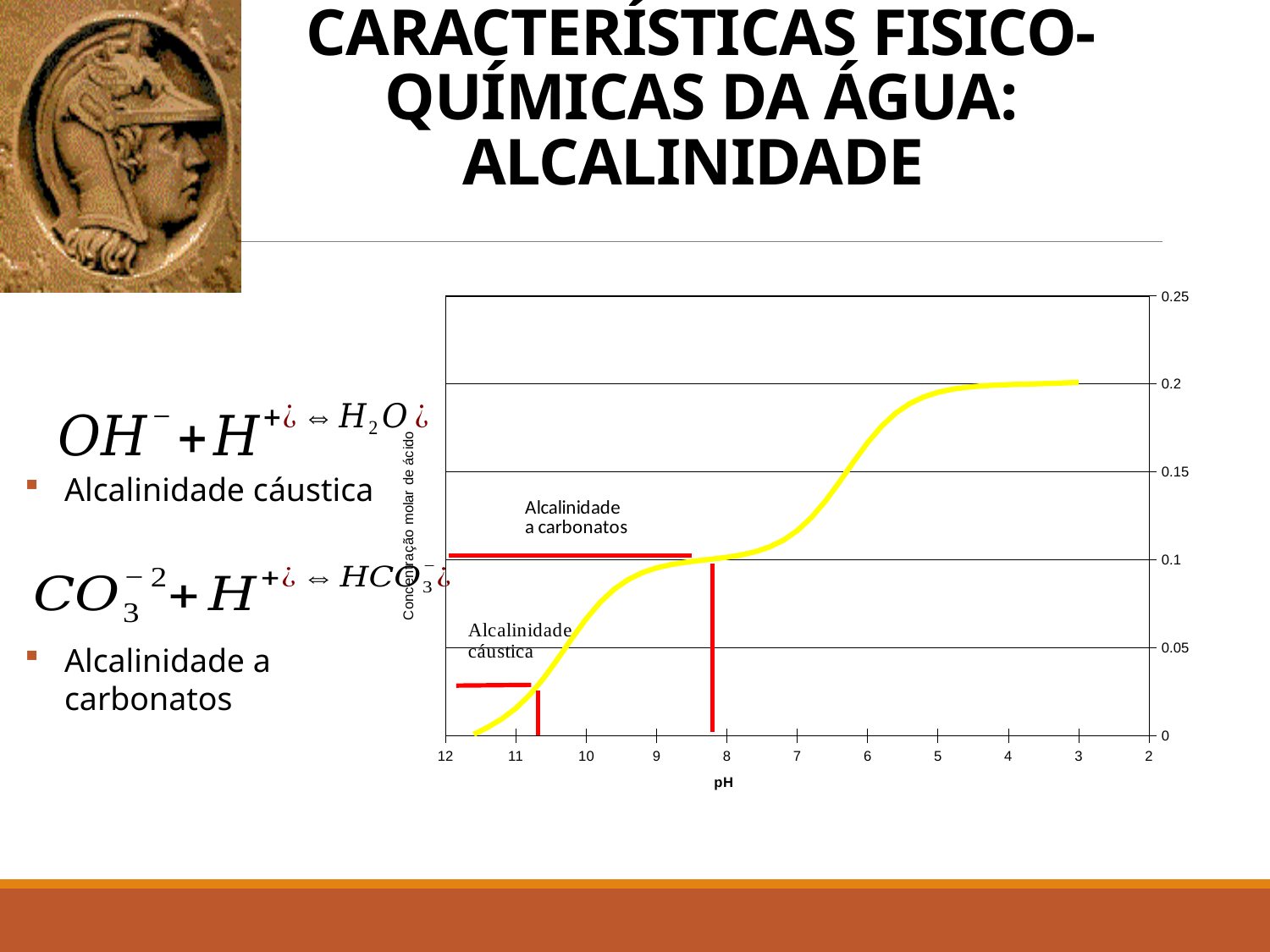
Is the value of the curve at pH 10 greater or less than 0.1? less How many tick labels are shown on the x axis of the chart? 11 Does the plotted curve rise or fall as you move from left to right along the x axis (from pH 12 to pH 2)? rise Which has the higher value on the curve, pH 4 or pH 10? pH 4 What is the label of the x axis of the chart? pH Is the value of the curve at pH 4 greater or less than 0.15? greater Is the value of the curve at pH 3 greater or less than 0.15? greater What are the two regions labelled in red on the chart? Alcalinidade cáustica and Alcalinidade a carbonatos What kind of chart is shown on the slide? line chart